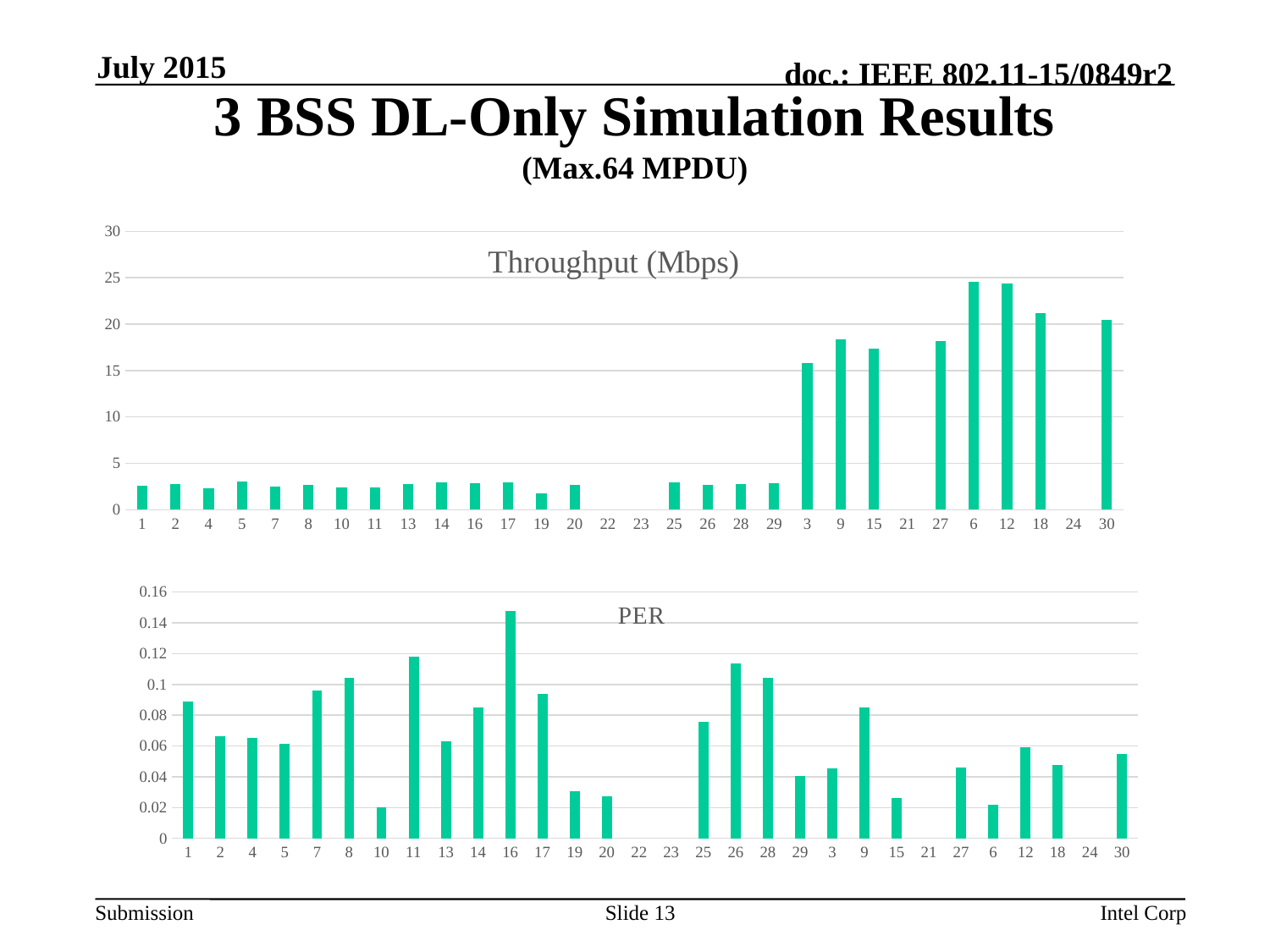
In the Throughput (Mbps) chart, is the value for category 6 greater or less than 20? greater In the PER chart, which has the larger value, category 26 or category 29? 26 In the Throughput (Mbps) chart, is the value for category 1 greater or less than 5? less In the Throughput (Mbps) chart, which has the larger value, category 3 or category 9? 9 In the PER chart, is the value for category 10 greater or less than 0.04? less What is the title of the top chart on the slide? Throughput (Mbps) In the Throughput (Mbps) chart, how many categories are shown on the x axis? 30 In the PER chart, which category has the highest value? 16 In the Throughput (Mbps) chart, which has the larger value, category 6 or category 3? 6 What kind of chart is the Throughput (Mbps) chart? bar chart